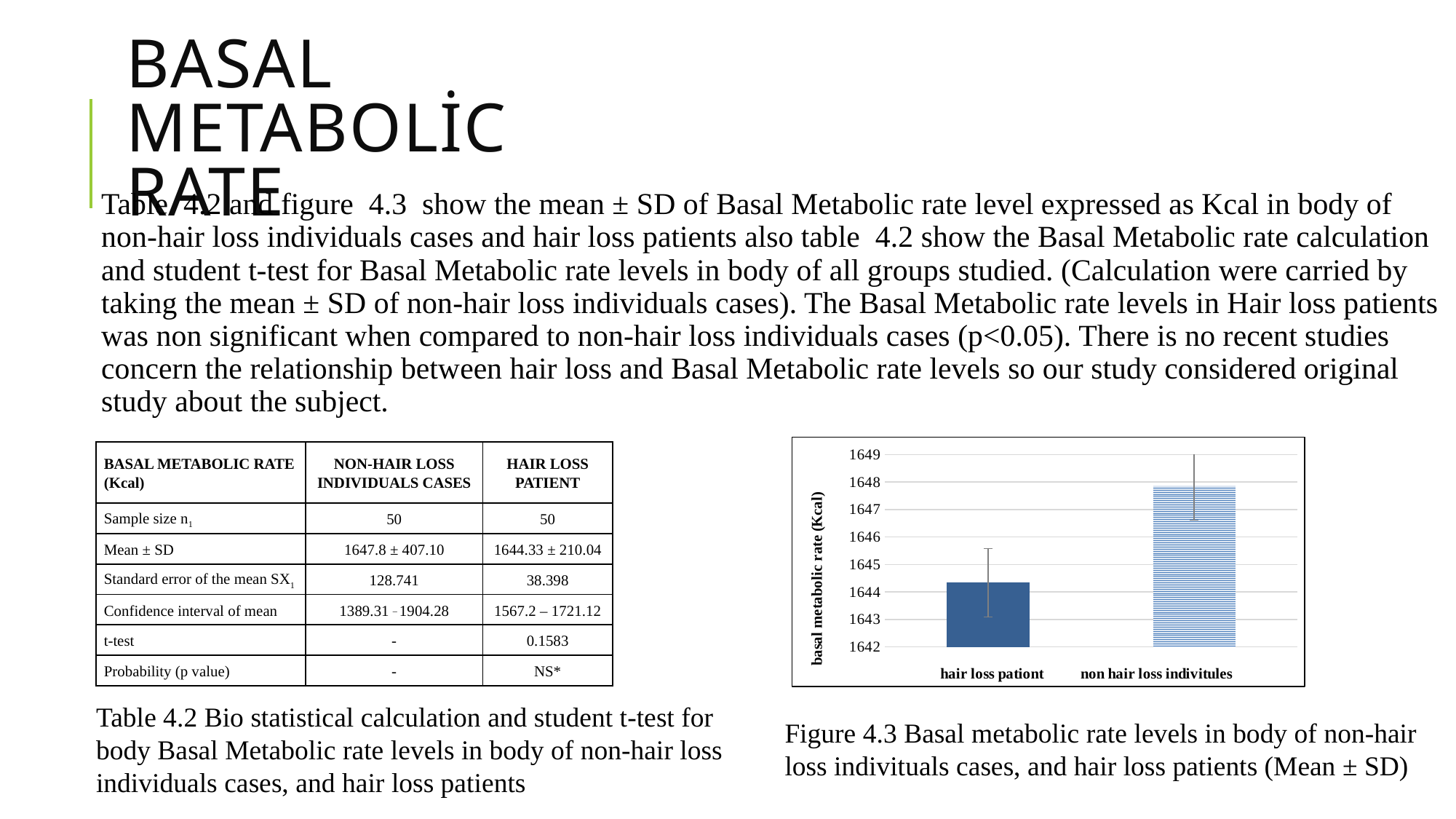
What is the lowest tick value shown on the vertical axis of the Figure 4.3 chart? 1642 How many categories are plotted in the Figure 4.3 chart? 2 In the Figure 4.3 chart, is the bar for hair loss patients or for non hair loss individuals taller? non hair loss indivitules In the Figure 4.3 chart, which category has the lowest bar? hair loss pationt In the Figure 4.3 chart, is the value for non hair loss indivitules greater or less than 1647? greater In the Figure 4.3 chart, is the value for hair loss pationt greater or less than 1643? greater In the Figure 4.3 chart, which category has the highest bar? non hair loss indivitules What kind of chart is shown in Figure 4.3? bar chart In the Figure 4.3 chart, is the value for hair loss pationt greater or less than 1645? less What is the label of the vertical axis in the Figure 4.3 chart? basal metabolic rate (Kcal)